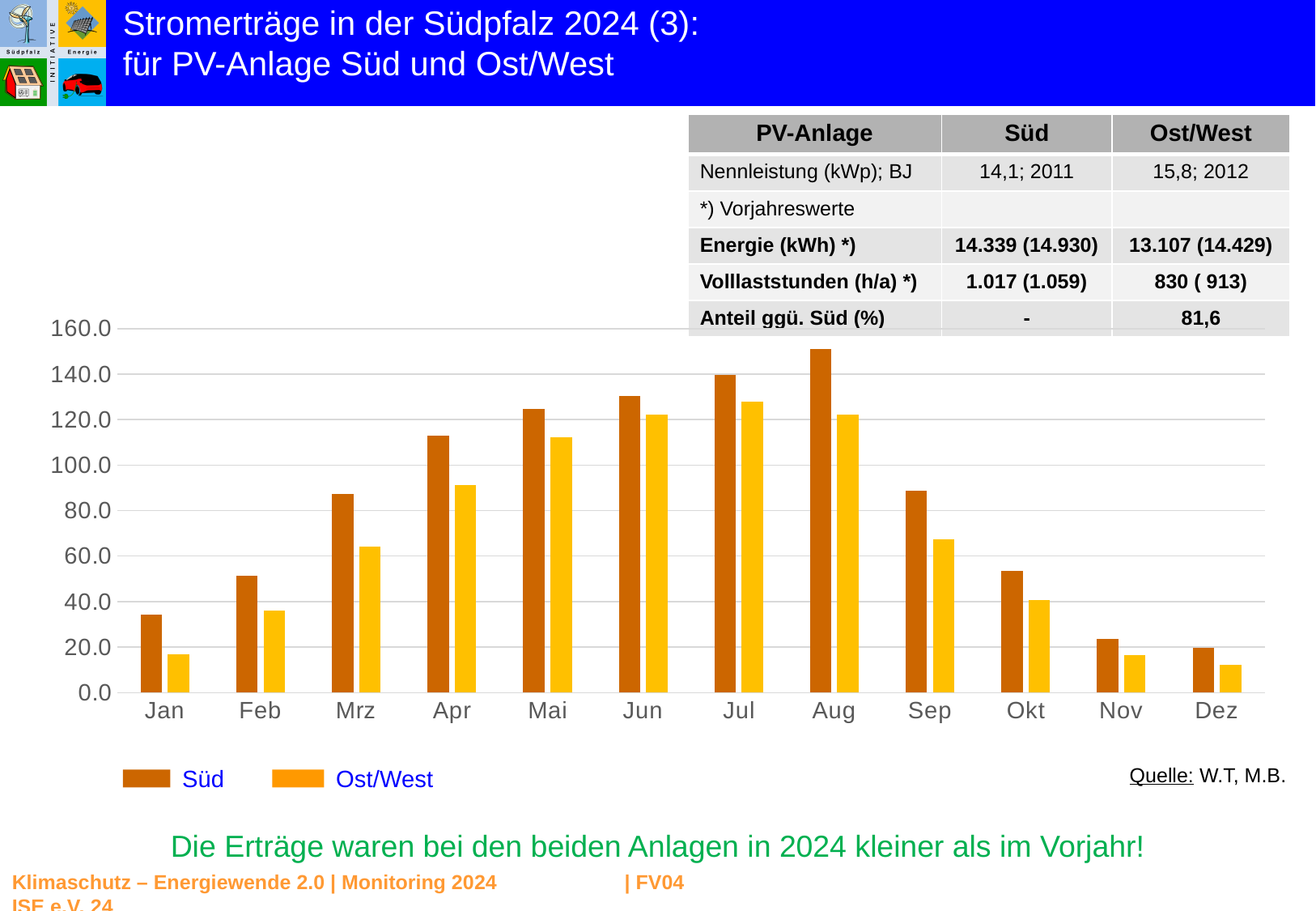
In which month is the Süd value highest? Aug Is the Süd value for Apr greater or less than 100? greater Which colour represents the Ost/West series in the chart? yellow/orange Is the Ost/West value for Jan greater or less than 20? less How many series does the chart legend list? 2 Which is larger in Mrz, the Süd value or the Ost/West value? Süd Is the Süd value for Aug greater or less than 140? greater How many months are shown on the x axis of the chart? 12 In which month is the Ost/West value lowest? Dez In which month is the Ost/West value highest? Jul Do the Süd values rise or fall from Jan to Aug? rise What kind of chart is shown on the slide? bar chart